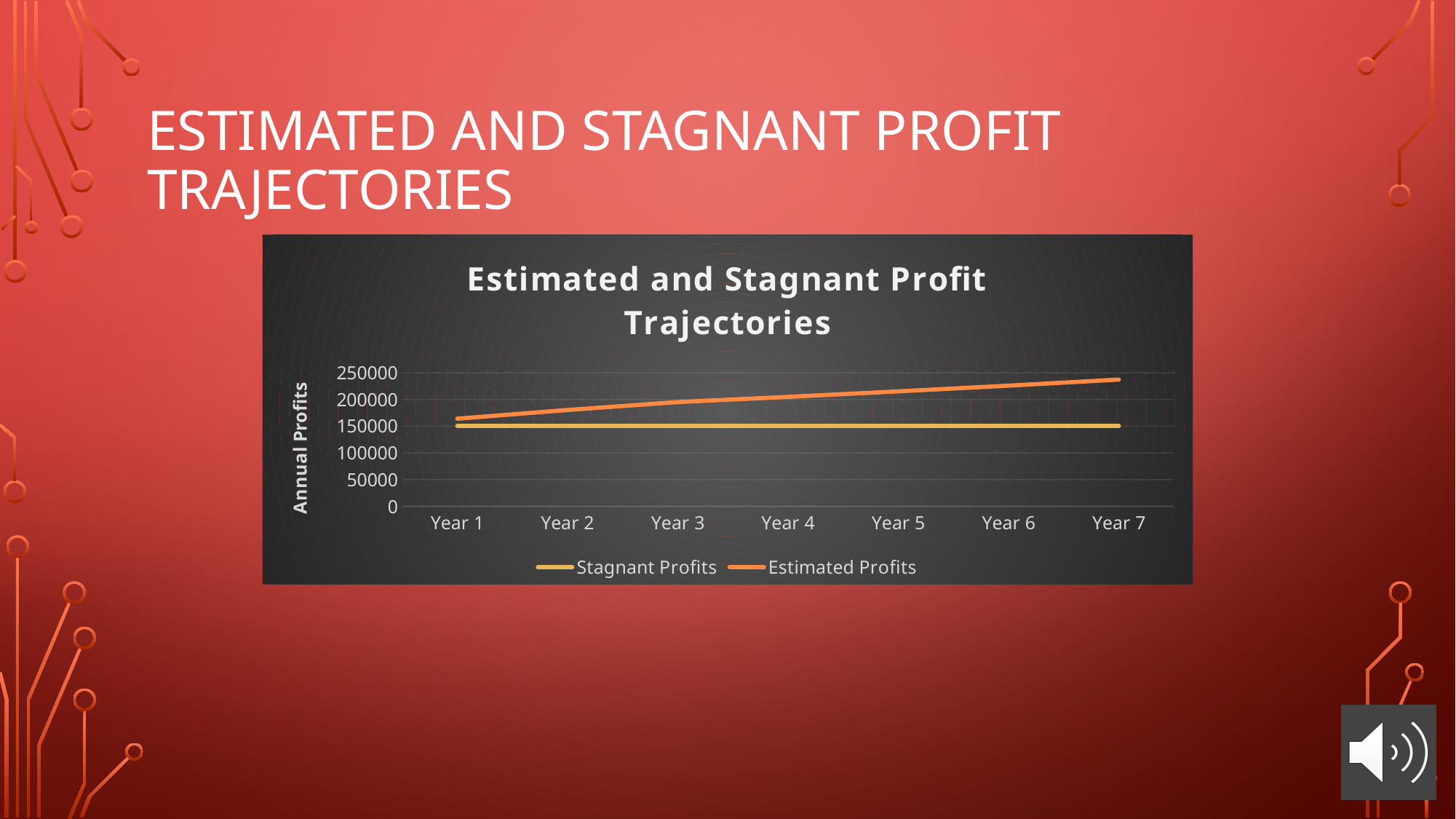
What is the title of the chart? Estimated and Stagnant Profit Trajectories What is the title of the vertical axis? Annual Profits In Year 7, which series has the larger value, Stagnant Profits or Estimated Profits? Estimated Profits In which year is the Estimated Profits value highest? Year 7 Is the Stagnant Profits value for Year 4 greater or less than 200000? less Is the Estimated Profits value for Year 7 greater or less than 200000? greater How many series does the legend list? 2 Do the Stagnant Profits values rise, fall, or stay flat from Year 1 to Year 7? Stay flat Is the Estimated Profits value for Year 1 greater or less than 200000? less What kind of chart is shown on the slide? Line chart Do the Estimated Profits values rise or fall from Year 1 to Year 7? Rise How many years are shown along the x axis? 7